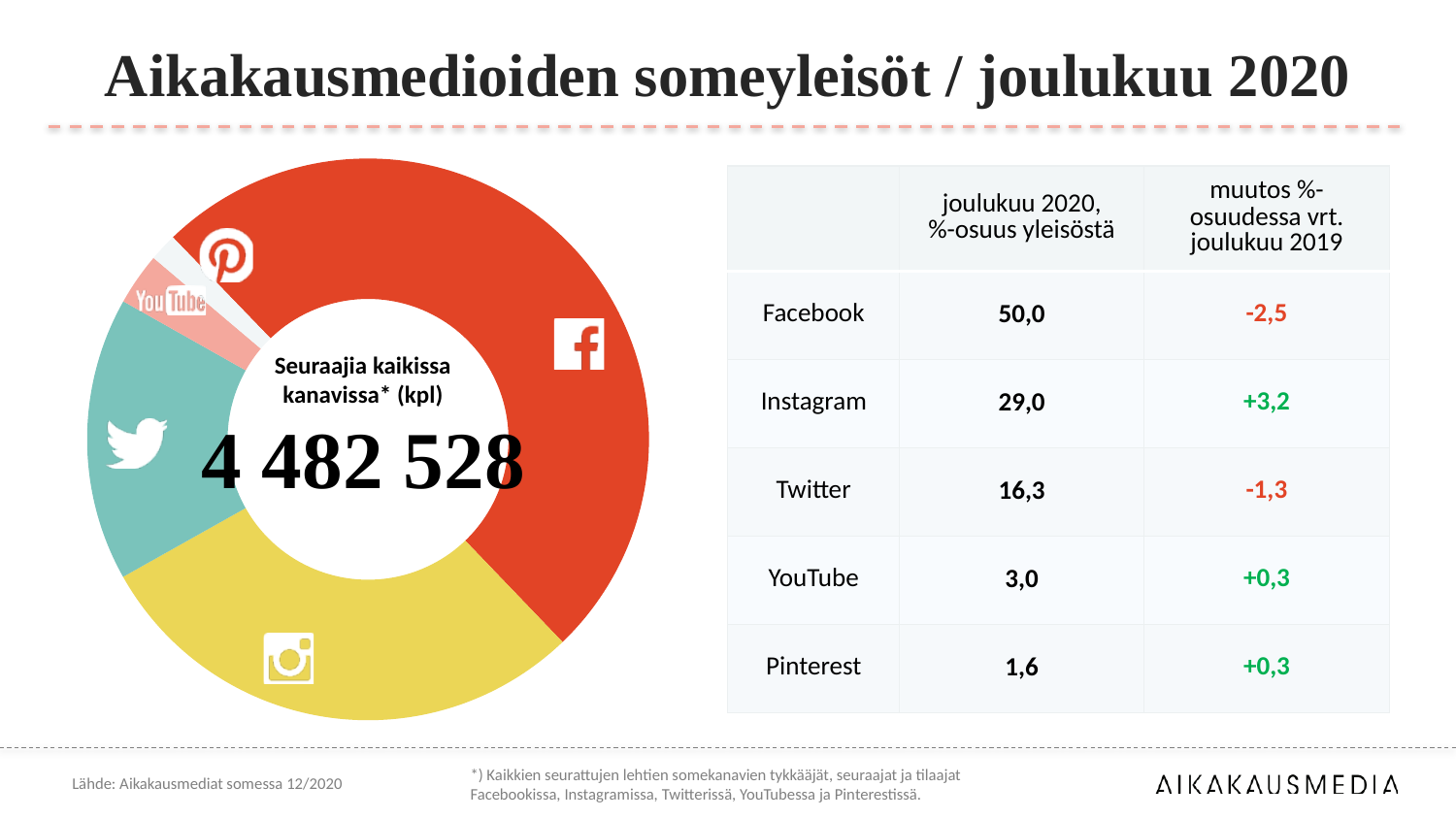
How many social media channels are shown as slices in the donut chart? 5 Which has a larger share of the audience, Twitter or YouTube? Twitter What is the total number of followers across all channels shown in the centre of the donut chart? 4 482 528 What kind of chart is shown on the left of the slide? Donut (pie) chart What is the difference in %-share between Facebook and Instagram in December 2020? 21,0 Which channel has the largest share of the audience in the donut chart? Facebook According to the table, what is Instagram's %-share of the audience in December 2020? 29,0 What is the change in Instagram's %-share compared with December 2019? +3,2 What is the change in Facebook's %-share compared with December 2019? -2,5 According to the table, what is Twitter's %-share of the audience in December 2020? 16,3 Which channel has the smallest share of the audience in the donut chart? Pinterest According to the table, what is Facebook's %-share of the audience in December 2020? 50,0